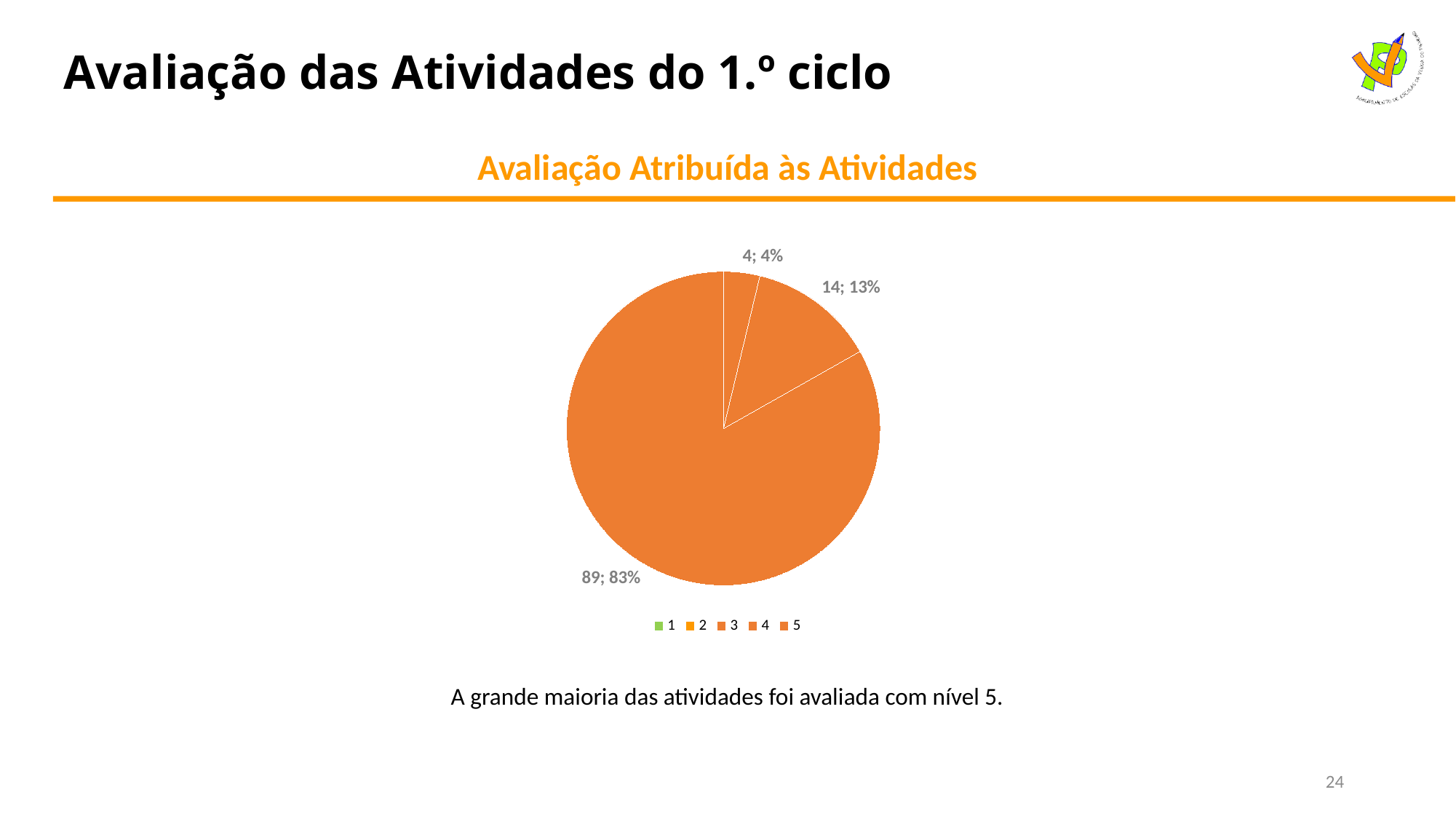
According to the slide, which evaluation level was assigned to the great majority of activities? 5 What percentage share does the slice with count 14 represent? 13% What is the difference between the slice with count 14 and the slice with count 4? 10 What is the data label of the largest slice of the pie? 89; 83% How many slices with data labels are visible in the pie chart? 3 What is the data label of the smallest slice of the pie? 4; 4% What kind of chart is shown on the slide? Pie chart What is the title of the chart? Avaliação Atribuída às Atividades How many entries does the chart legend list? 5 Which slice is larger: the one labelled 14; 13% or the one labelled 4; 4%? 14; 13% What is the total count across the three labelled slices? 107 What percentage share does the largest slice represent? 83%